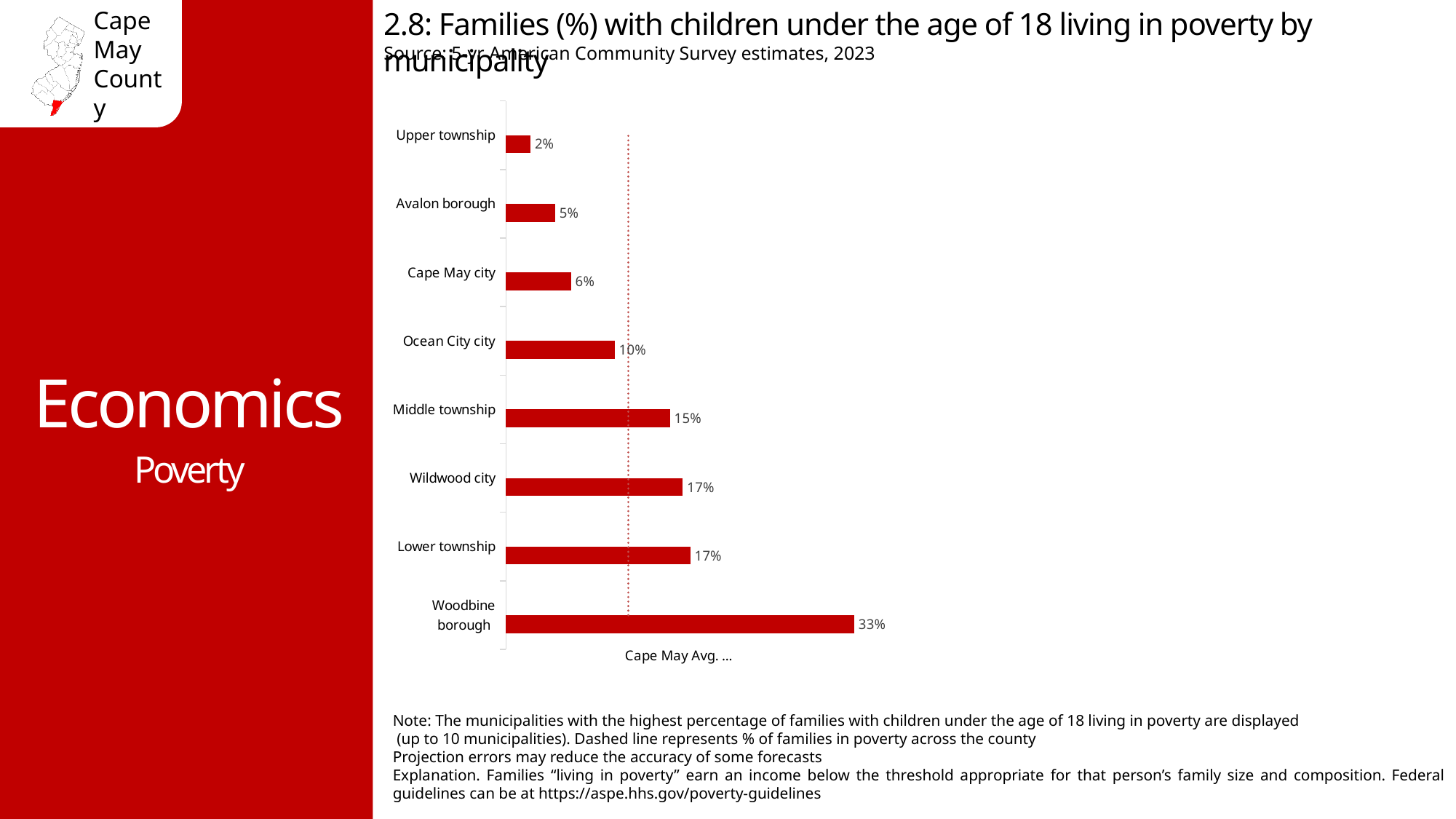
What is the value shown for Ocean City city? 10% What kind of chart is used on this slide? Bar chart What percentage of families with children under 18 are living in poverty in Woodbine borough? 33% Which municipality has the highest percentage of families with children living in poverty? Woodbine borough What is the difference between the values for Cape May city and Avalon borough? 1% What is the difference between the values for Woodbine borough and Lower township? 16% Which municipality has the lowest percentage of families with children living in poverty? Upper township What is the value shown for Upper township? 2% What does the dashed vertical line in the chart represent? Cape May Avg. How many municipalities are shown in the chart? 8 Which has a higher value, Middle township or Ocean City city? Middle township What is the value shown for Middle township? 15%